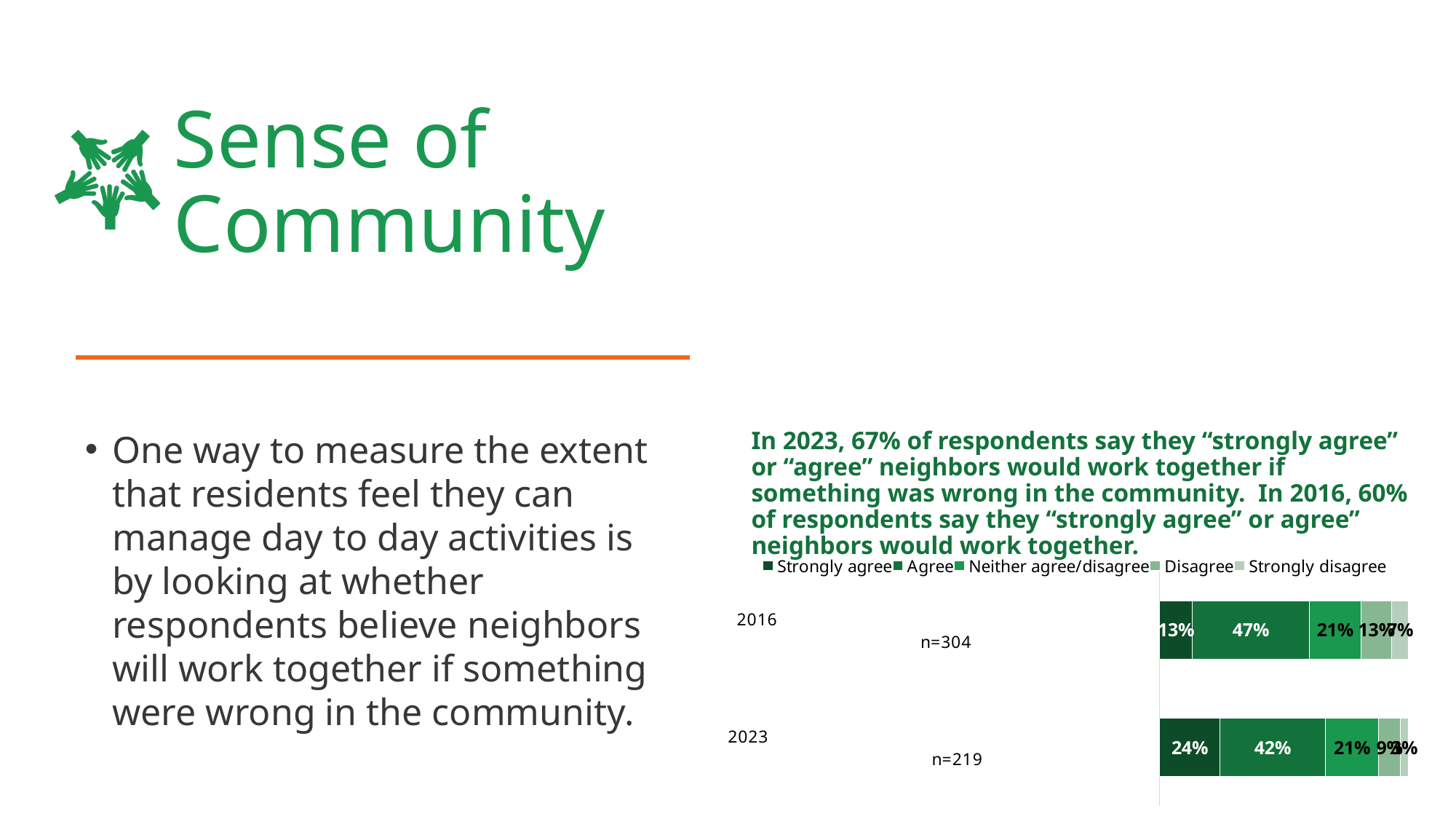
How many years (bars) are shown in the chart? 2 Which year had a larger "agree" share, 2016 or 2023? 2016 What is the sample size (n) shown for the 2023 bar? n=219 What percentage of respondents in 2016 said they "strongly agree" that neighbors would work together? 13% By how many percentage points did the "strongly agree" share change from 2016 to 2023? 11 percentage points What percentage of respondents in 2016 said they "agree"? 47% How many response categories does the legend list? 5 What type of chart is used to show the survey responses? Stacked bar chart Which year had a larger "strongly agree" share, 2016 or 2023? 2023 What percentage of respondents in 2023 said they "strongly agree" that neighbors would work together? 24% What percentage of respondents in 2023 chose "neither agree/disagree"? 21% What percentage of respondents in 2023 said they "agree"? 42%